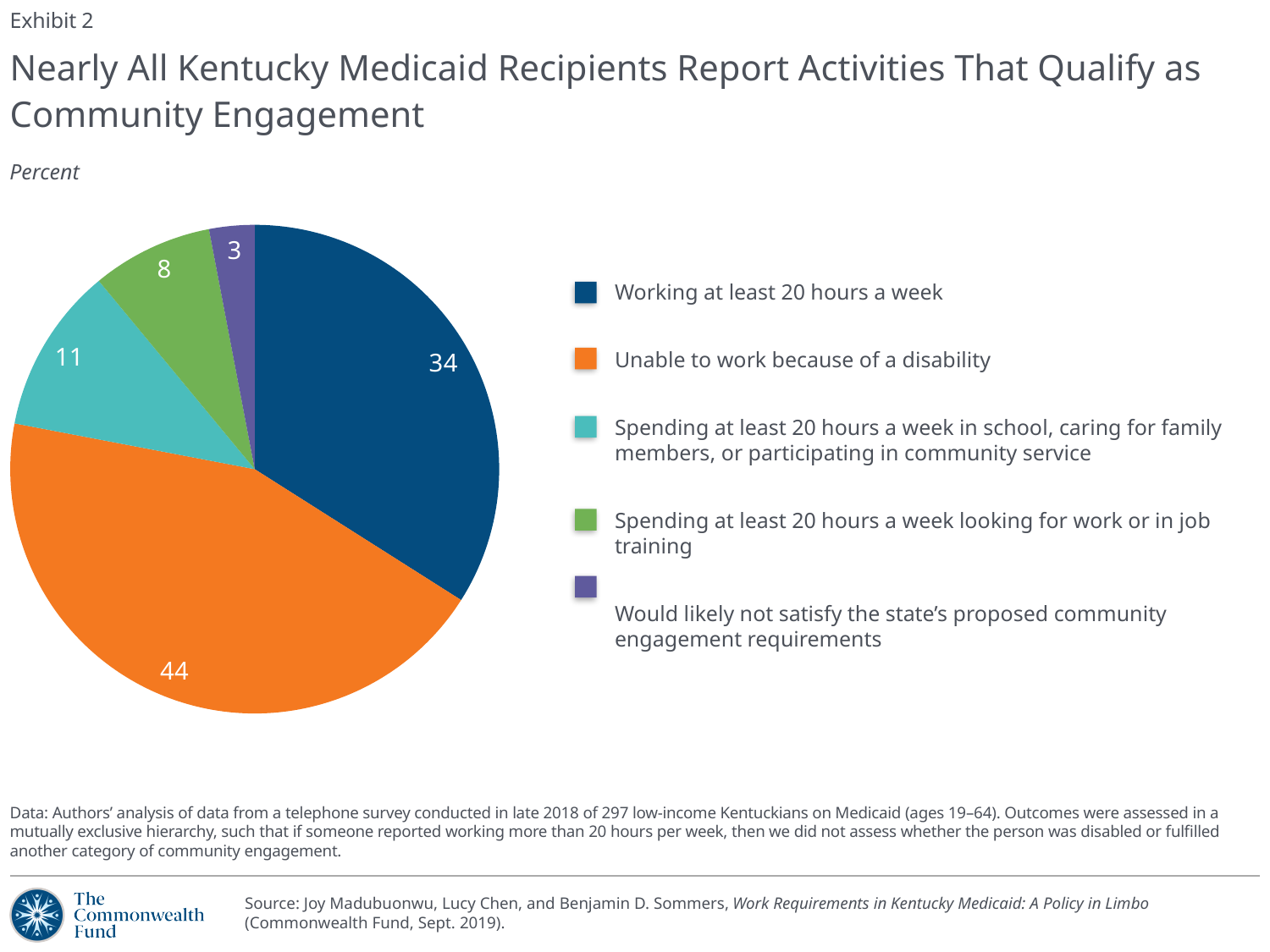
What unit does the chart report, according to the label under the title? Percent How many slices does the pie chart have? 5 What percent of recipients spend at least 20 hours a week in school, caring for family members, or participating in community service? 11 What colour is the slice for 'Working at least 20 hours a week'? dark blue What percent of Kentucky Medicaid recipients report working at least 20 hours a week? 34 Which category has the largest share of the pie? Unable to work because of a disability Which category has the smallest share of the pie? Would likely not satisfy the state's proposed community engagement requirements What is the difference in percentage points between recipients unable to work because of a disability and those working at least 20 hours a week? 10 Which is larger: the share spending at least 20 hours a week looking for work or in job training, or the share spending at least 20 hours a week in school, caring for family members, or participating in community service? Spending at least 20 hours a week in school, caring for family members, or participating in community service What kind of chart is shown on the slide? pie chart What percent of recipients would likely not satisfy the state's proposed community engagement requirements? 3 What percent of recipients are unable to work because of a disability? 44